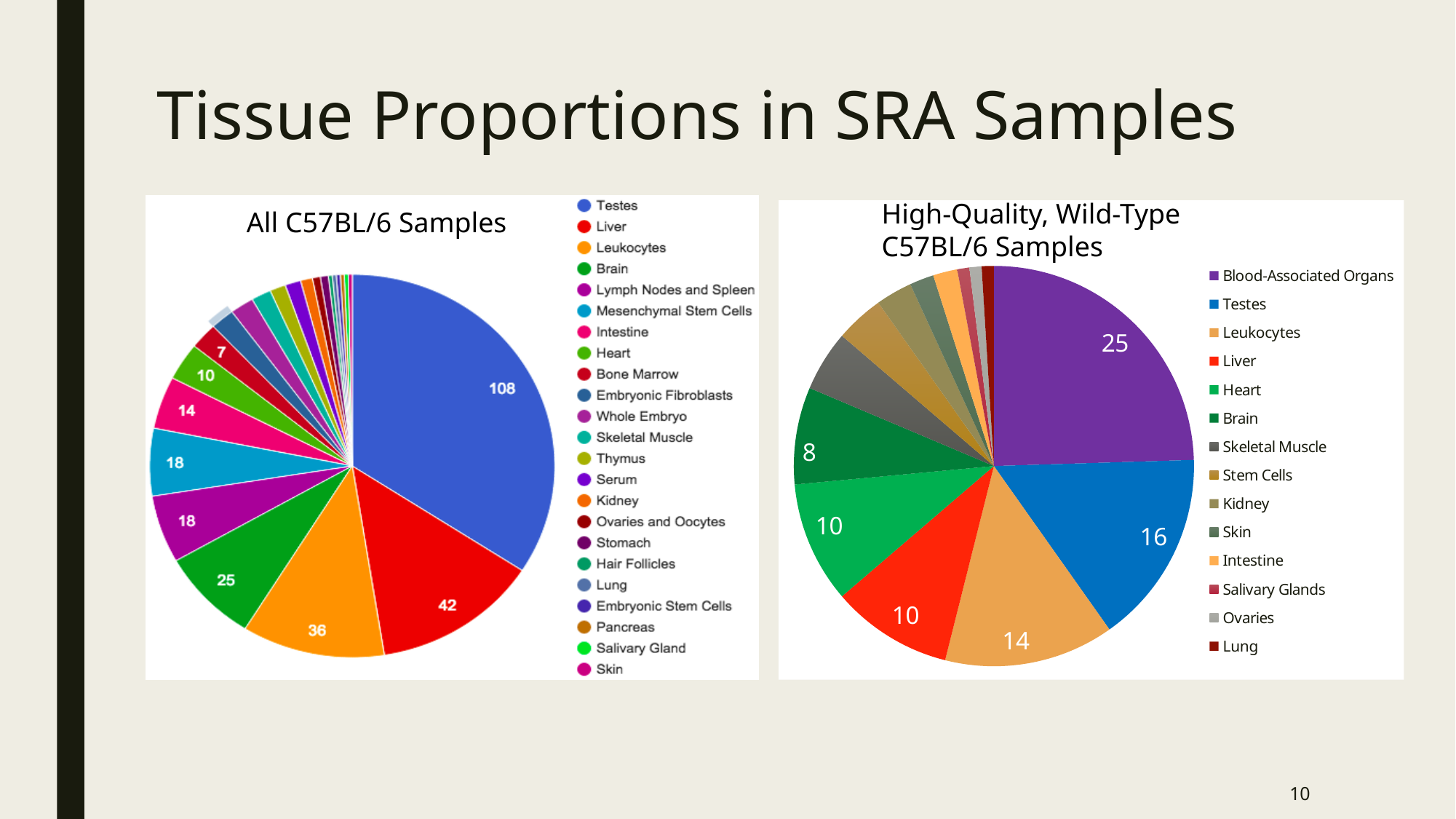
In the All C57BL/6 Samples chart, what value is shown for Liver? 42 In the High-Quality, Wild-Type C57BL/6 Samples chart, what value is shown for Blood-Associated Organs? 25 In the All C57BL/6 Samples chart, what value is shown for Testes? 108 What type of chart is used for the All C57BL/6 Samples data? Pie chart How many categories does the legend of the High-Quality, Wild-Type C57BL/6 Samples chart list? 14 In the All C57BL/6 Samples chart, which is larger, Brain or Intestine? Brain In the All C57BL/6 Samples chart, what is the difference between the Testes value and the Liver value? 66 In the High-Quality, Wild-Type C57BL/6 Samples chart, which category has the largest slice? Blood-Associated Organs In the All C57BL/6 Samples chart, which tissue has the largest slice? Testes In the All C57BL/6 Samples chart, what value is shown for Leukocytes? 36 In the High-Quality, Wild-Type C57BL/6 Samples chart, what value is shown for Testes? 16 In the High-Quality, Wild-Type C57BL/6 Samples chart, what is the difference between the Leukocytes value and the Brain value? 6